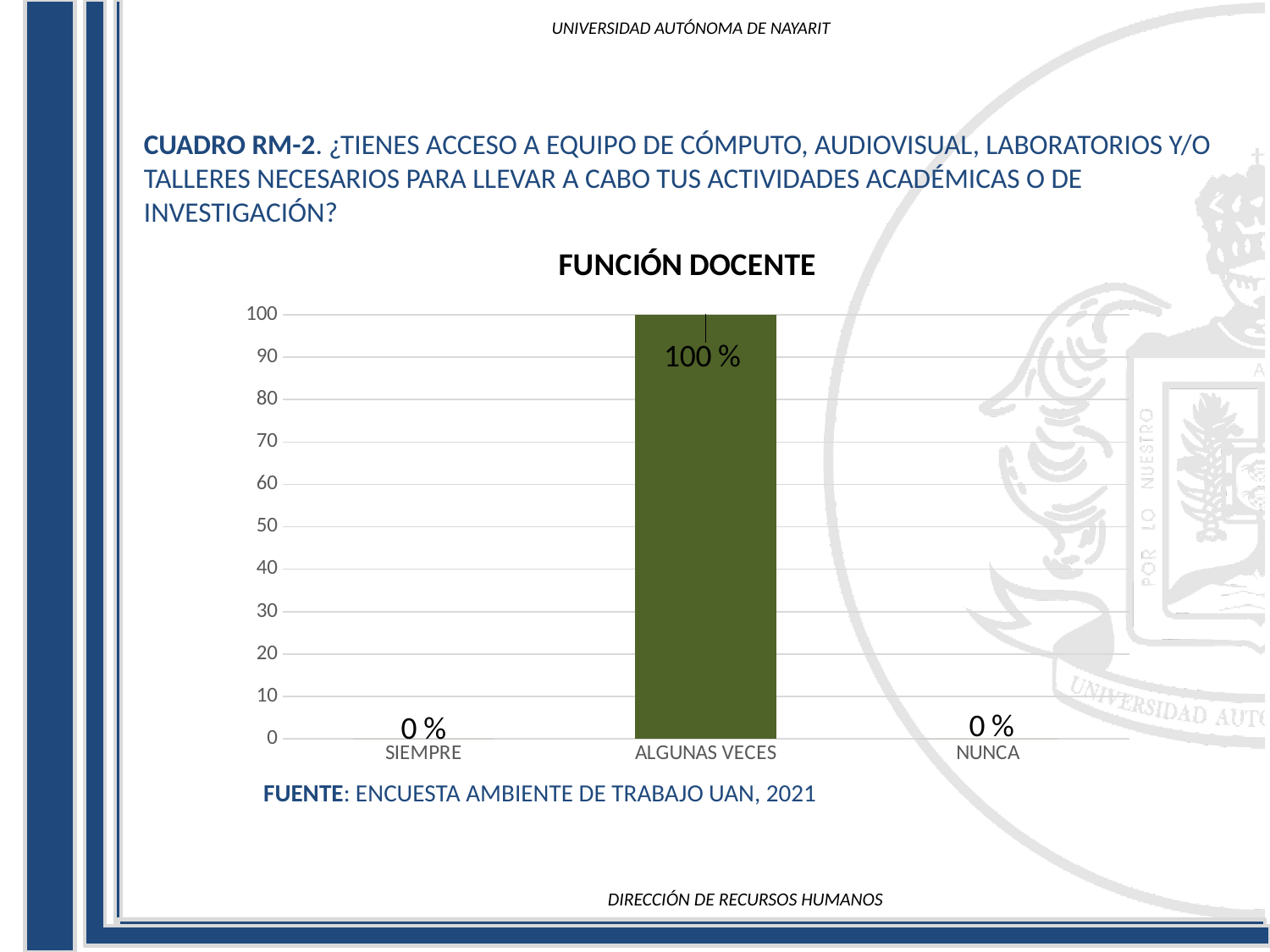
What is the value for SIEMPRE? 0 % What is the value for ALGUNAS VECES? 100 % What is the value for NUNCA? 0 % What is the highest value shown on the y axis? 100 What is the difference between the values for ALGUNAS VECES and SIEMPRE? 100 % What is the title of the chart? FUNCIÓN DOCENTE Is the value for ALGUNAS VECES greater or less than 50? greater What kind of chart is shown on the slide? bar chart Which is larger, the value for ALGUNAS VECES or the value for NUNCA? ALGUNAS VECES Which category has the highest value? ALGUNAS VECES How many categories are shown on the x axis? 3